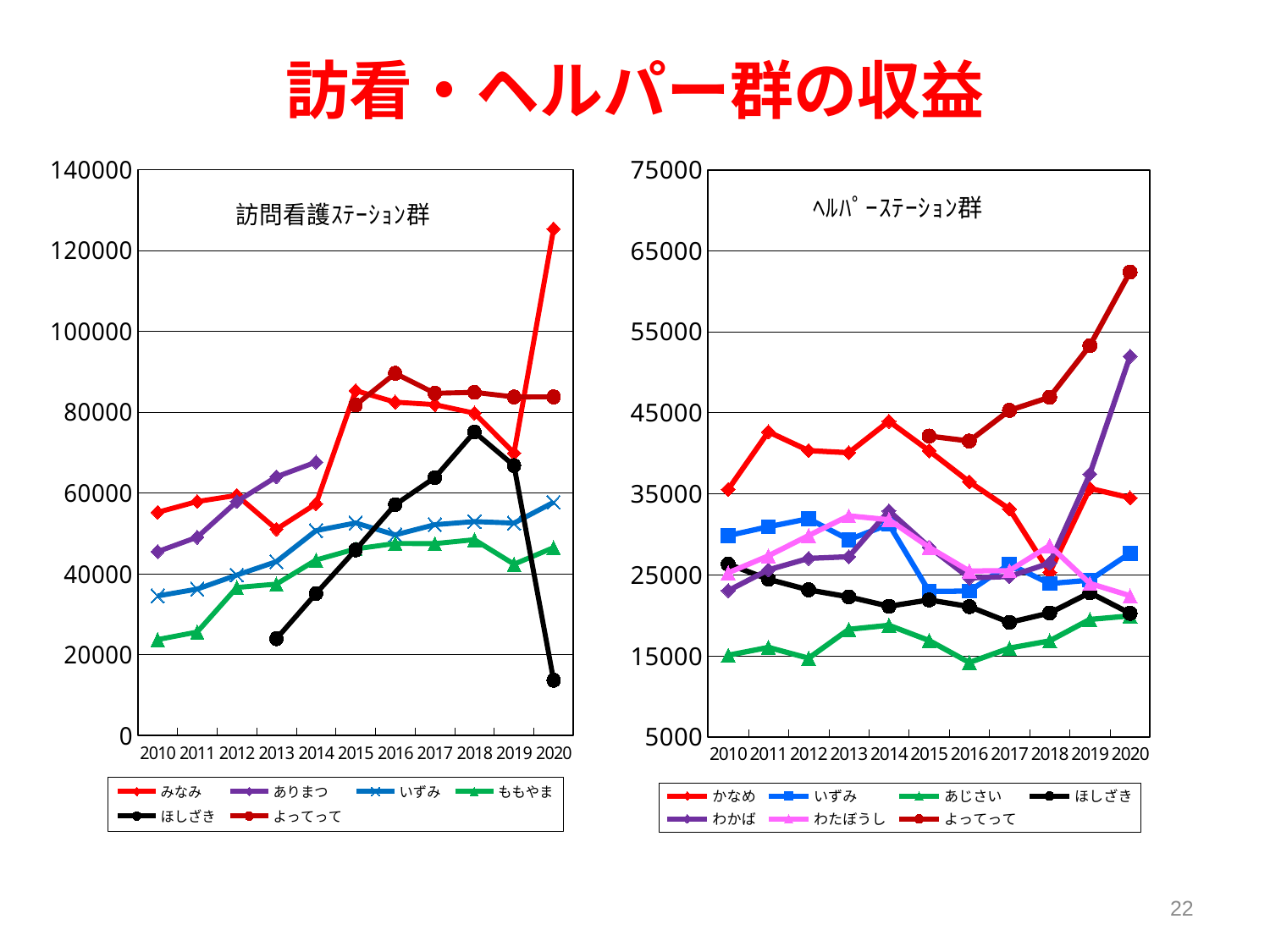
In the left chart (訪問看護ステーション群), which is larger in 2018, ほしざき or いずみ? ほしざき In the right chart (ヘルパーステーション群), how many years are shown on the x axis? 11 In the left chart (訪問看護ステーション群), is the value for みなみ in 2020 greater or less than 120000? greater In the left chart (訪問看護ステーション群), is the value for ほしざき in 2020 greater or less than 20000? less What kind of chart is the left chart titled 訪問看護ステーション群? line chart In the right chart (ヘルパーステーション群), is the value for わかば in 2020 greater or less than 45000? greater In the left chart (訪問看護ステーション群), how many series does the legend list? 6 In the right chart (ヘルパーステーション群), does the value for よってって rise or fall from 2016 to 2020? rise What is the title of the slide? 訪看・ヘルパー群の収益 In the right chart (ヘルパーステーション群), how many series does the legend list? 7 In the right chart (ヘルパーステーション群), which series has the highest value in 2020? よってって In the right chart (ヘルパーステーション群), which series has the lowest value in 2016? あじさい